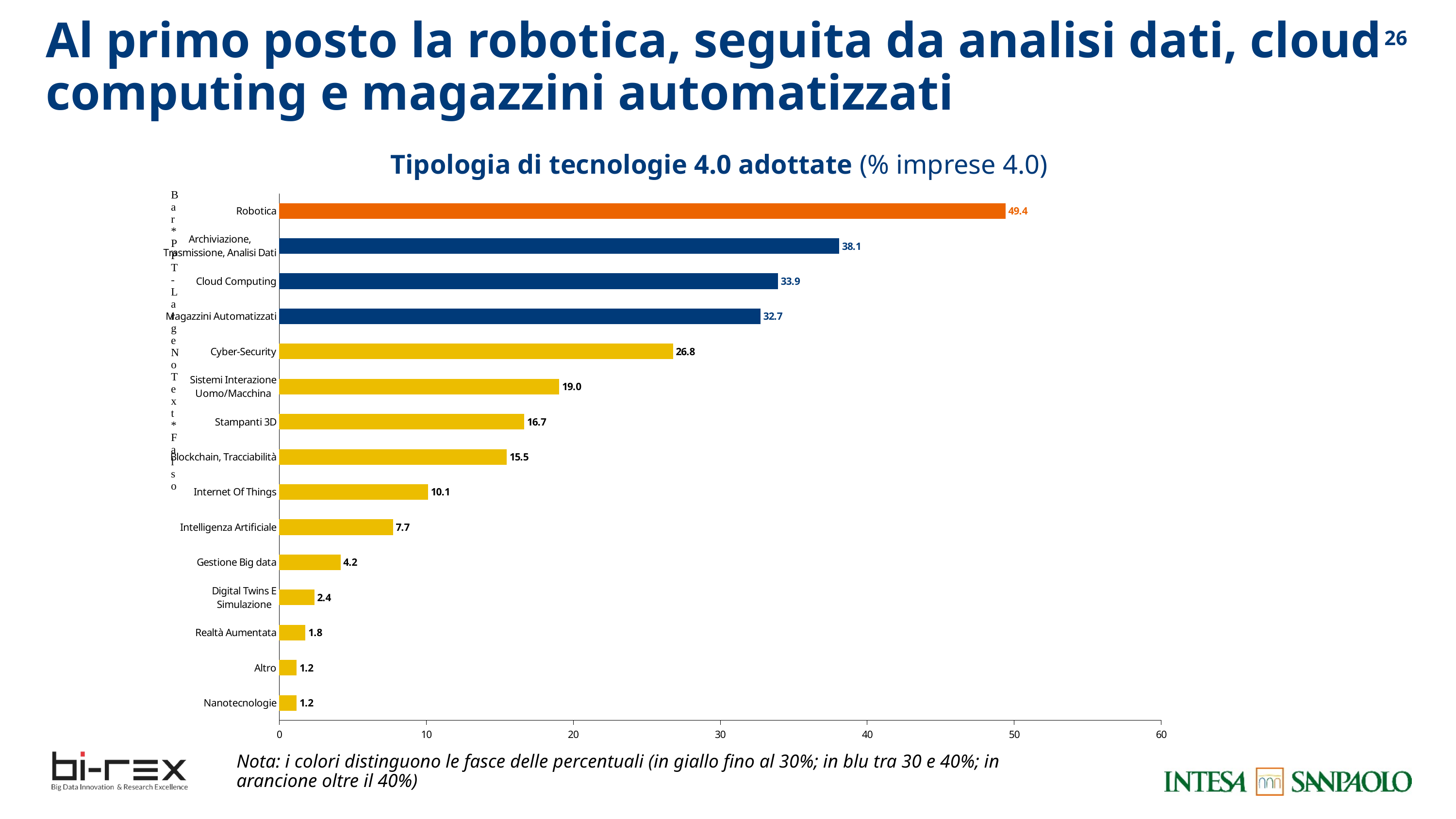
What colour is the bar for Robotica? orange What is the value for Internet Of Things? 10.1 How many categories are shown in the chart? 15 Which is larger, the value for Magazzini Automatizzati or the value for Cloud Computing? Cloud Computing What type of chart is shown on the slide? bar chart What is the difference between the values for Cyber-Security and Stampanti 3D? 10.1 What is the value for Cyber-Security? 26.8 What is the value for Robotica? 49.4 Which category has the highest value? Robotica What is the difference between the values for Robotica and Cloud Computing? 15.5 What is the value for Cloud Computing? 33.9 Is the value for Archiviazione, Trasmissione, Analisi Dati greater or less than 40? less